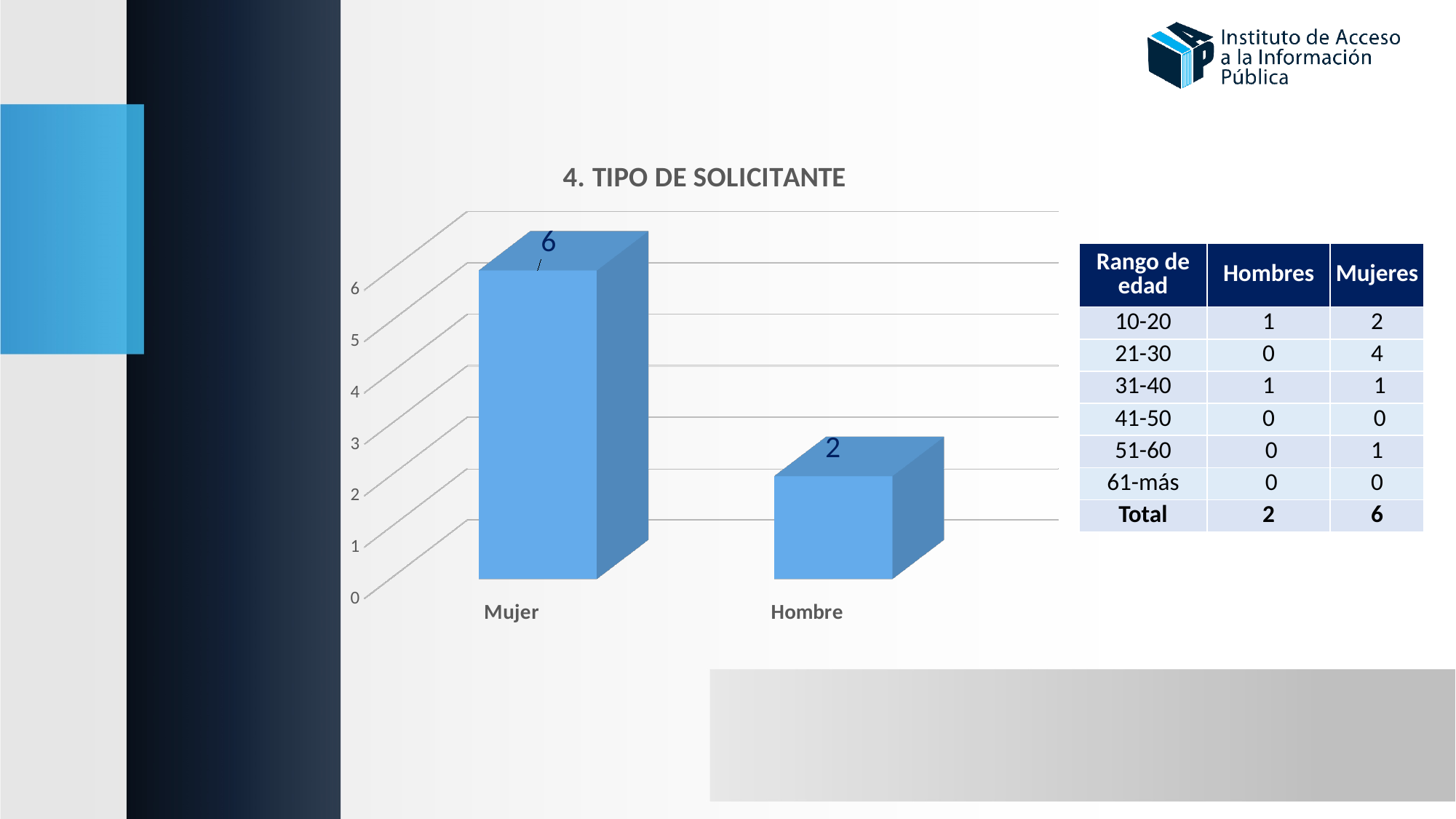
Which category has the highest value? Mujer How many categories are shown on the x axis? 2 What is the value for Mujer? 6 Which category has the lowest value? Hombre What is the title of the chart? 4. TIPO DE SOLICITANTE What kind of chart is shown? bar chart Is the value for Mujer greater or less than 4? greater Is the value for Hombre greater or less than 3? less What is the highest value shown on the vertical axis? 6 What is the value for Hombre? 2 Which is larger, the value for Mujer or the value for Hombre? Mujer What is the difference between the values for Mujer and Hombre? 4